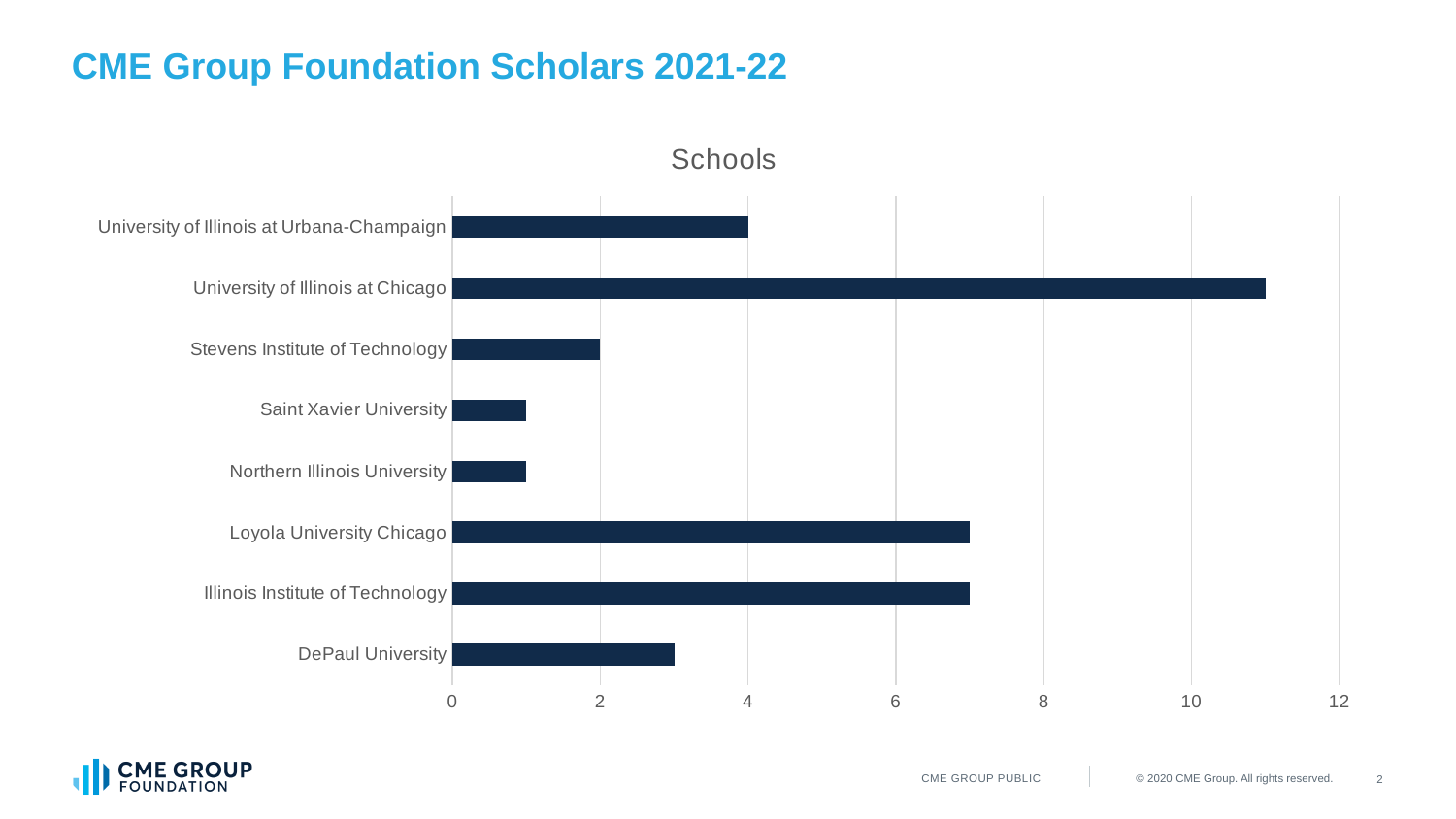
Which has a larger value, DePaul University or Saint Xavier University? DePaul University What is the value for Stevens Institute of Technology? 2 What is the value for University of Illinois at Urbana-Champaign? 4 How many schools are listed in the chart? 8 What is the title of the chart? Schools Which school has the highest value in the chart? University of Illinois at Chicago Is the value for Loyola University Chicago greater or less than 6? greater Is the value for University of Illinois at Chicago greater or less than 10? greater What is the difference between the values for University of Illinois at Urbana-Champaign and Stevens Institute of Technology? 2 What type of chart is shown on the slide? bar chart Which has a larger value, University of Illinois at Chicago or Loyola University Chicago? University of Illinois at Chicago Is the value for DePaul University greater or less than 4? less